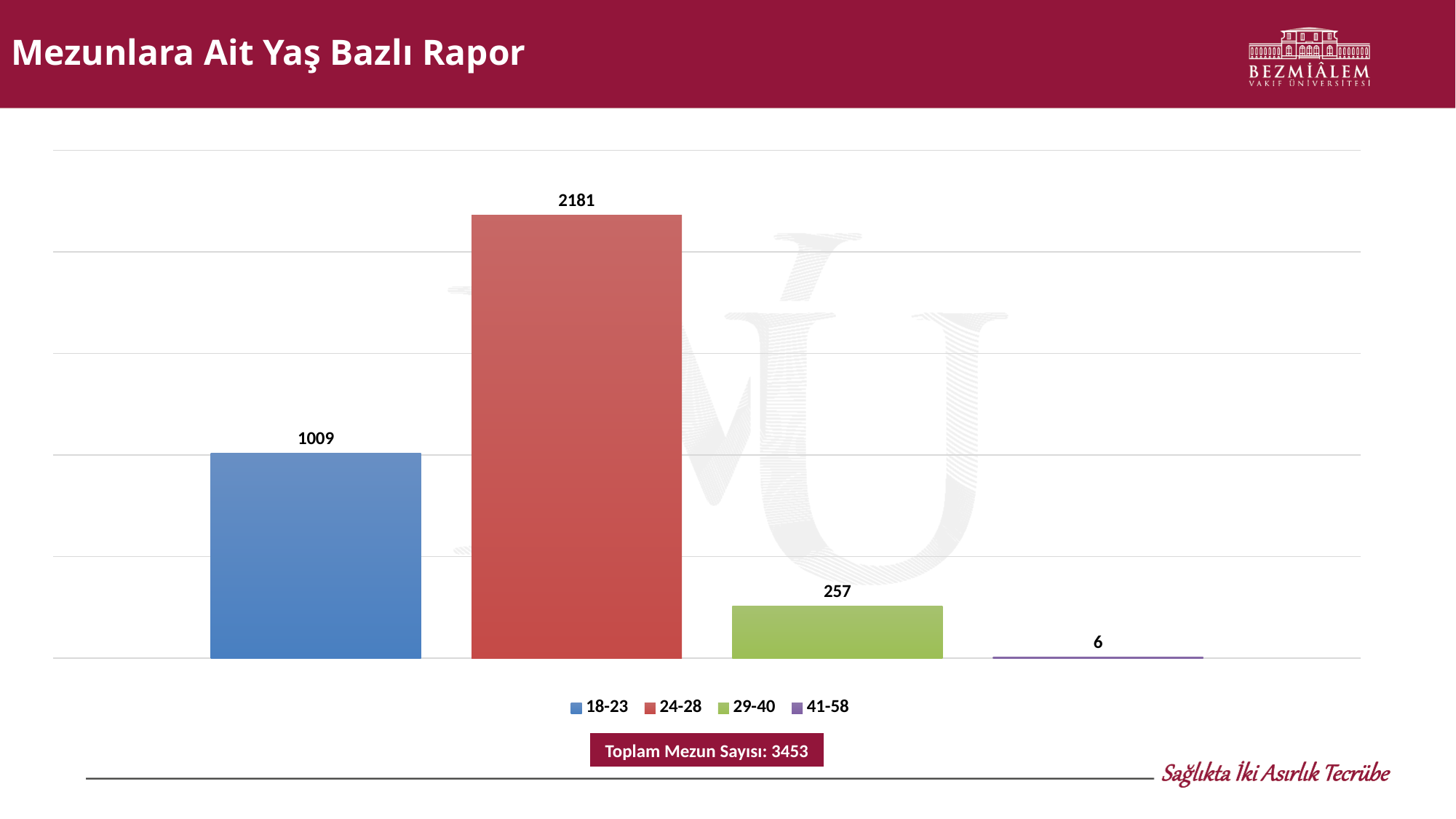
What total number of graduates (Toplam Mezun Sayısı) is stated below the chart? 3453 What is the difference between the values for 29-40 and 41-58? 251 What is the difference between the values for 24-28 and 18-23? 1172 What is the value for the 29-40 age group? 257 How many age groups are shown in the chart? 4 What is the value for the 18-23 age group? 1009 Which age group has the highest value? 24-28 What is the value for the 24-28 age group? 2181 What is the value for the 41-58 age group? 6 Which age group has the lowest value? 41-58 What kind of chart is shown on the slide? bar chart Which is larger, the value for 18-23 or the value for 29-40? 18-23